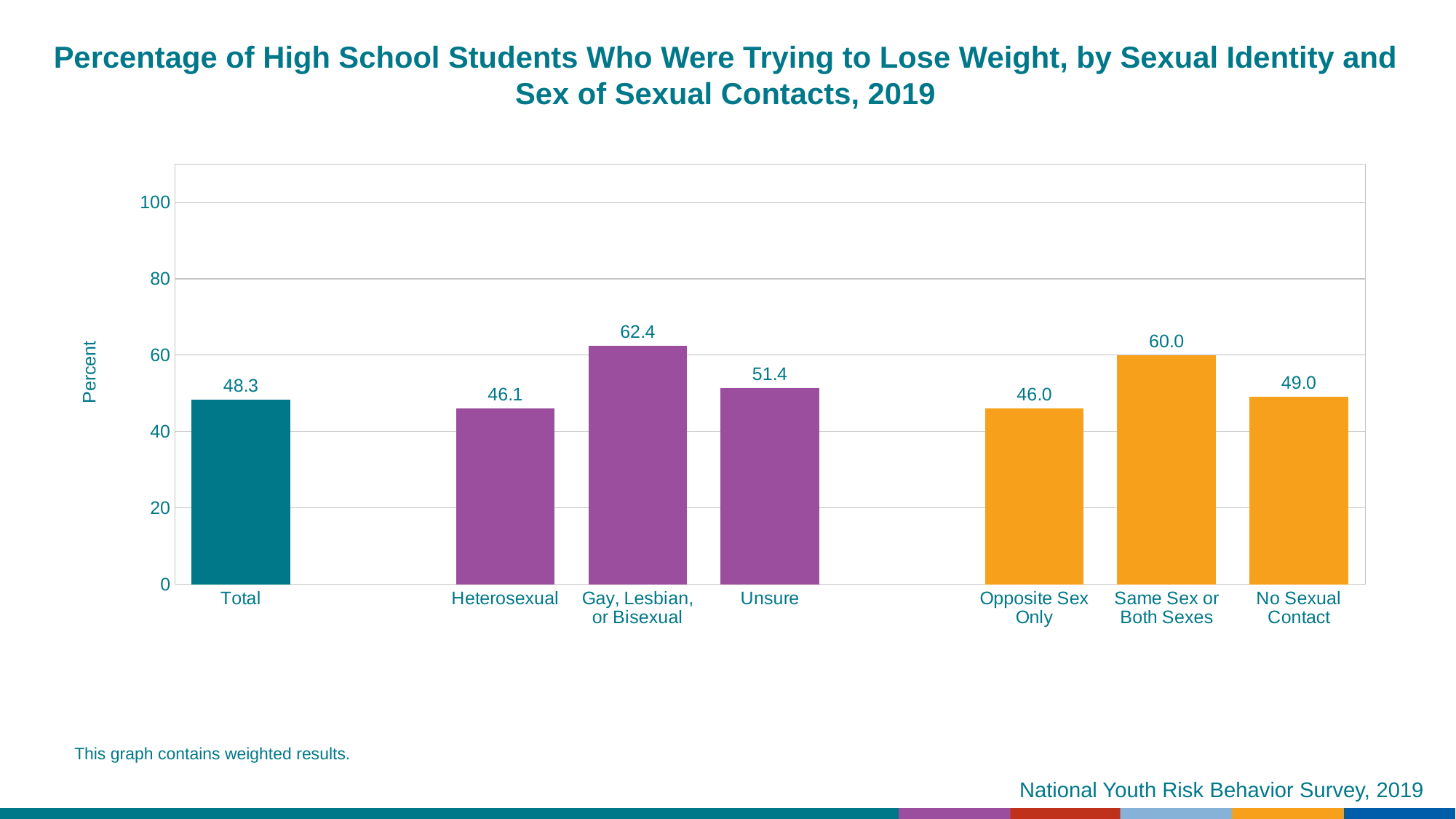
What is the difference between the values for Gay, Lesbian, or Bisexual and Heterosexual? 16.3 What is the value for Total? 48.3 What kind of chart is shown on the slide? Bar chart Which is larger, the value for Unsure or the value for Heterosexual? Unsure Which category has the highest value? Gay, Lesbian, or Bisexual What is the value for Gay, Lesbian, or Bisexual students? 62.4 Which category has the lowest value? Opposite Sex Only What is the label of the vertical axis? Percent What is the difference between the values for Same Sex or Both Sexes and No Sexual Contact? 11.0 What is the value for Same Sex or Both Sexes? 60.0 How many categories are shown on the chart? 7 Is the value for Same Sex or Both Sexes greater or less than 40? greater